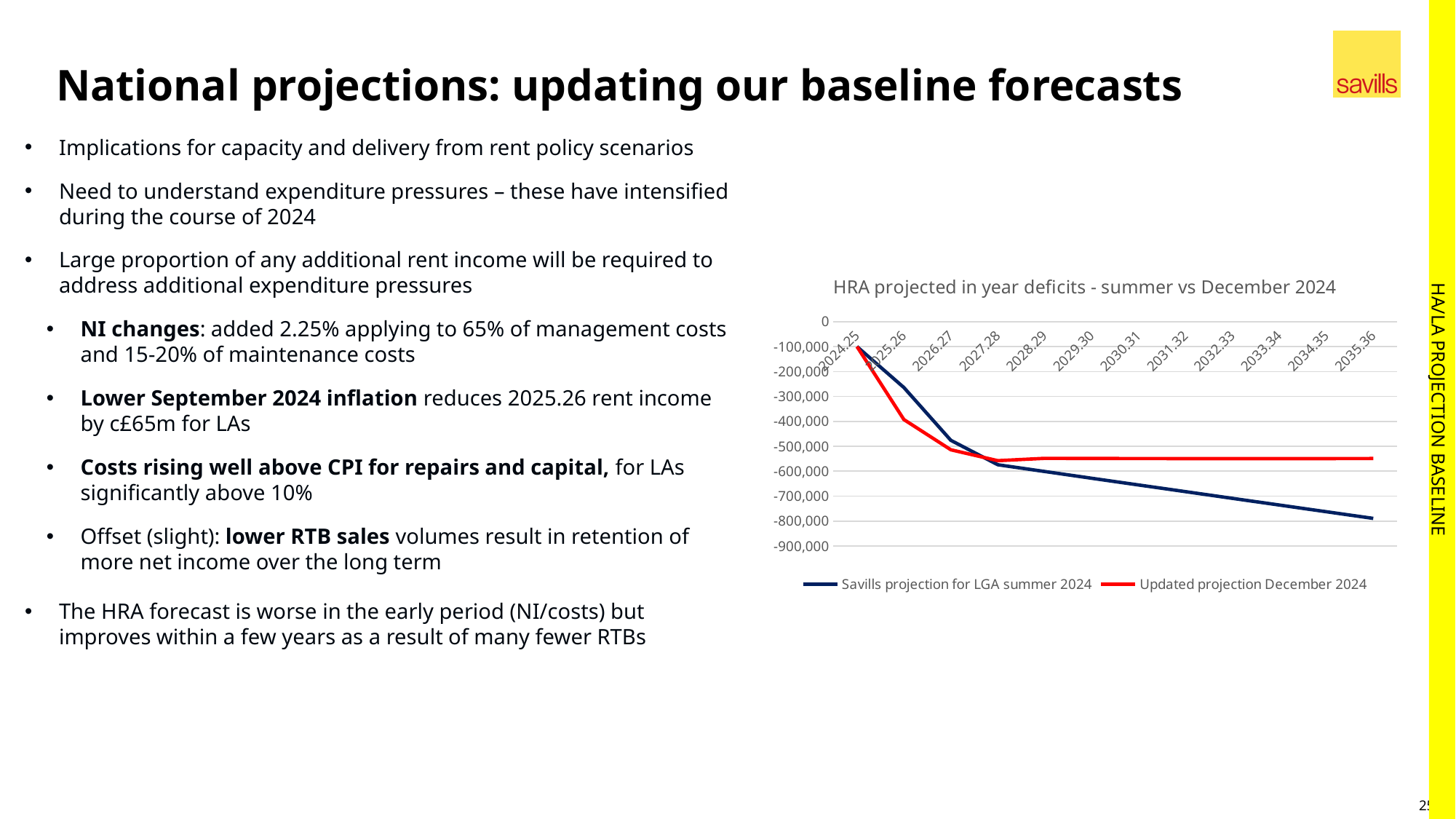
Which colour is used for the 'Updated projection December 2024' line? red In which year does the 'Savills projection for LGA summer 2024' series reach its lowest value? 2035.36 Is the value of 'Savills projection for LGA summer 2024' at 2035.36 greater or less than -700,000? less Does the 'Savills projection for LGA summer 2024' line rise or fall from 2024.25 to 2035.36? fall At 2035.36, which series has the lower value: 'Savills projection for LGA summer 2024' or 'Updated projection December 2024'? Savills projection for LGA summer 2024 How many years are plotted along the x axis of the chart? 12 What is the title of the chart? HRA projected in year deficits - summer vs December 2024 Is the value of 'Updated projection December 2024' at 2035.36 greater or less than -600,000? greater At 2025.26, which series shows the larger deficit (lower value): 'Savills projection for LGA summer 2024' or 'Updated projection December 2024'? Updated projection December 2024 How many series does the chart legend list? 2 What kind of chart is shown on the slide? line chart Is the value of 'Savills projection for LGA summer 2024' at 2030.31 greater or less than -600,000? less